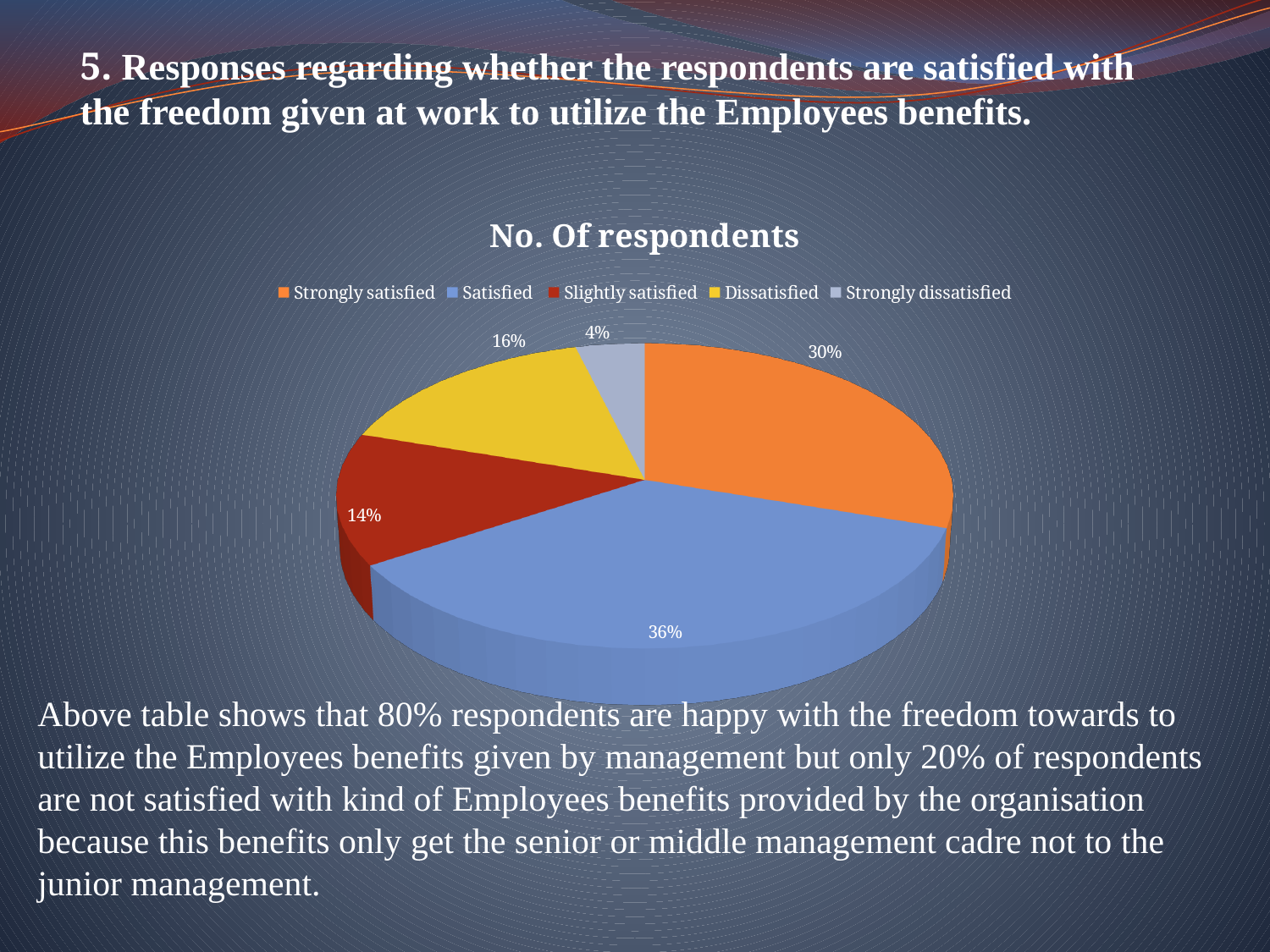
How many categories does the legend list? 5 What kind of chart is shown on the slide? Pie chart What percentage of respondents are Satisfied? 36% Which category has the largest share of the pie? Satisfied What is the difference between the Satisfied and Strongly satisfied shares? 6% Which is larger, the Dissatisfied share or the Slightly satisfied share? Dissatisfied What percentage of respondents are Strongly satisfied? 30% What percentage of respondents are Strongly dissatisfied? 4% What percentage of respondents are Dissatisfied? 16% What is the chart's title? No. Of respondents Which category has the smallest share of the pie? Strongly dissatisfied What percentage of respondents are Slightly satisfied? 14%